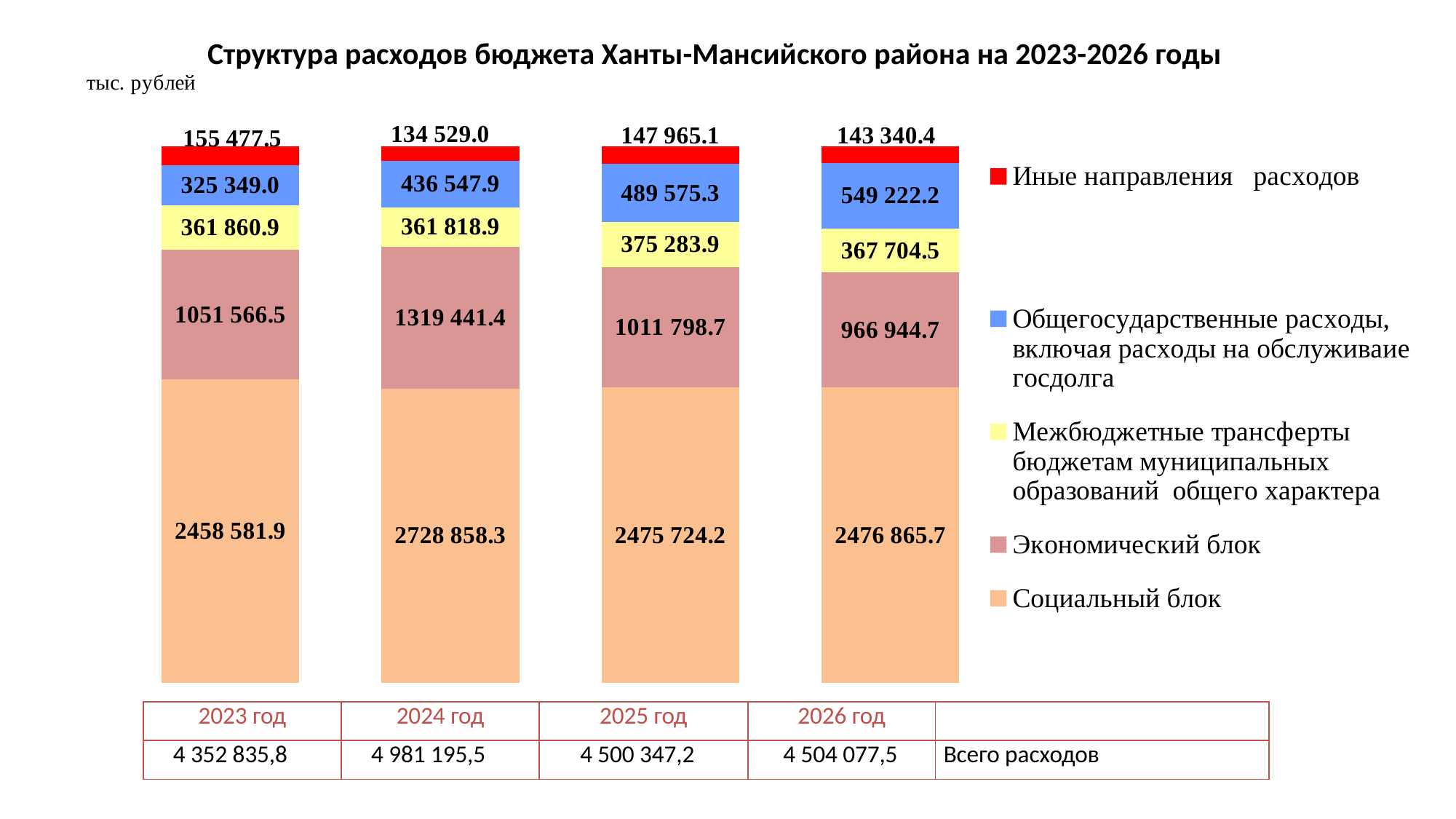
What is the value of Социальный блок for 2024 год? 2728 858.3 In which year is the Социальный блок value the highest? 2024 год How many series does the legend list? 5 What is the value of Экономический блок for 2025 год? 1011 798.7 Do the Общегосударственные расходы values rise or fall from 2023 год to 2026 год? Rise Which is larger: Экономический блок in 2023 год or in 2024 год? 2024 год What is the total of the stacked bar for 2023 год? 4 352 835,8 What is the value of Иные направления расходов for 2026 год? 143 340.4 What is the difference between the Общегосударственные расходы values for 2026 год and 2023 год? 223 873.2 In which year is the Иные направления расходов value the lowest? 2024 год How many years (categories) are shown on the x axis? 4 What kind of chart is shown on the slide? Stacked bar chart